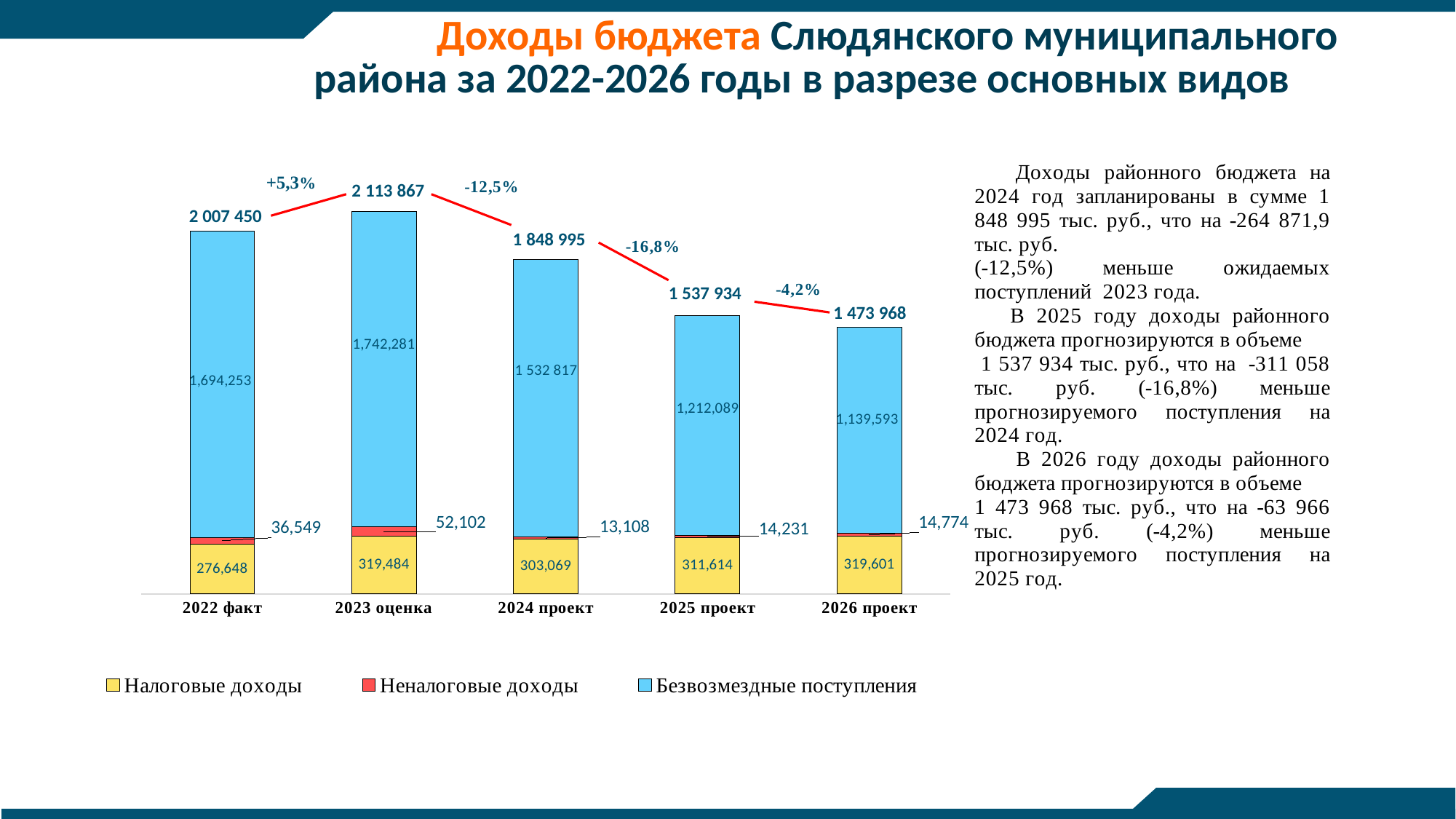
Which year has the lowest value of Неналоговые доходы? 2024 проект What type of chart is shown on the slide? stacked bar chart What is the value of Безвозмездные поступления for 2025 проект? 1,212,089 What is the value of Налоговые доходы for 2023 оценка? 319,484 Which is larger: Налоговые доходы for 2022 факт or for 2025 проект? 2025 проект What is the total of the stacked bar for 2026 проект? 1 473 968 How many categories (years) are shown on the x axis? 5 What percentage change is shown between 2024 проект and 2025 проект? -16,8% How many series does the legend list? 3 What is the difference between the totals for 2023 оценка and 2024 проект? 264 872 Which year has the highest total budget income? 2023 оценка What is the value of Неналоговые доходы for 2024 проект? 13,108